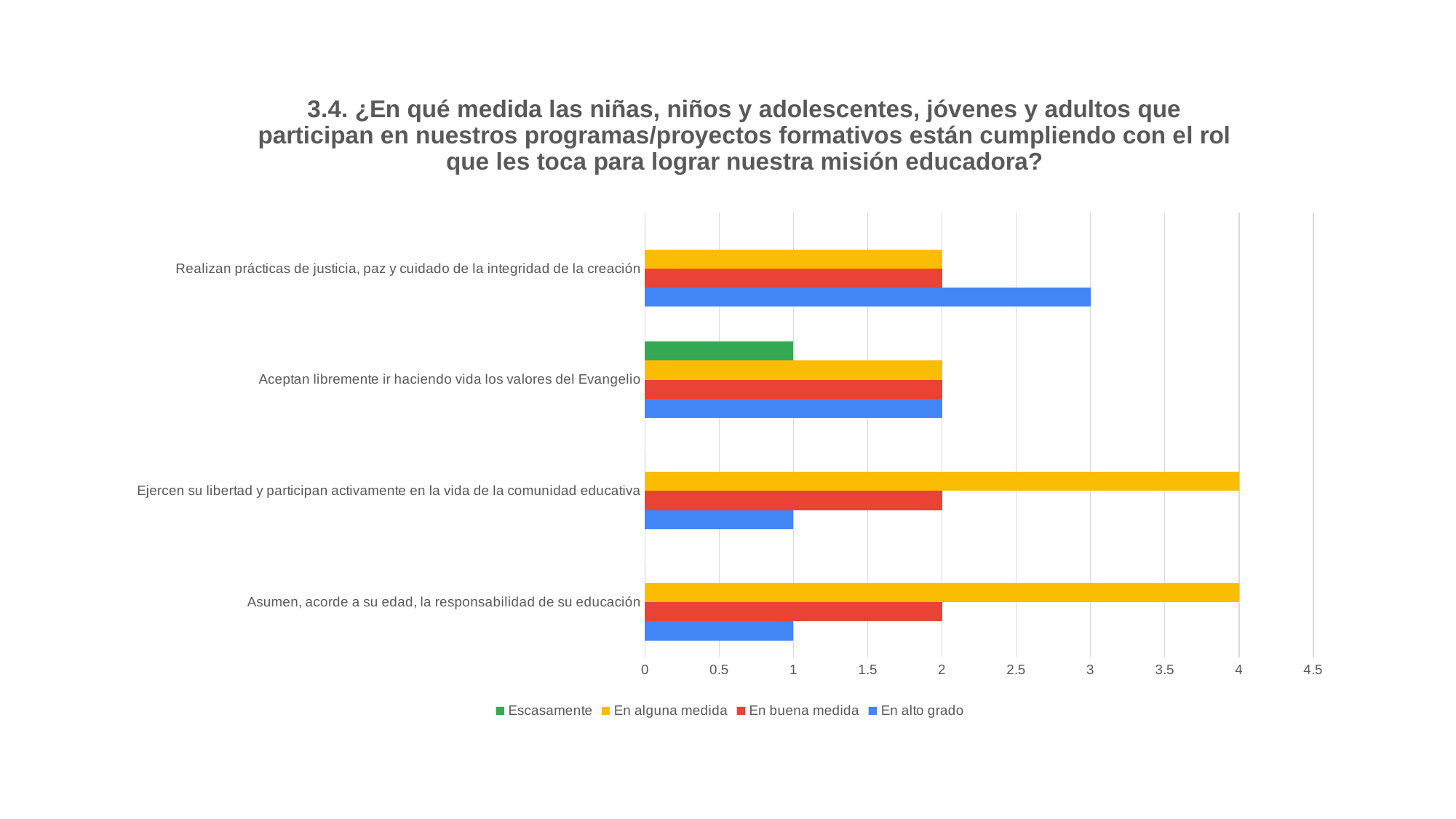
Which category has the highest value for 'En alto grado'? Realizan prácticas de justicia, paz y cuidado de la integridad de la creación What is the value of 'Escasamente' for 'Aceptan libremente ir haciendo vida los valores del Evangelio'? 1 What is the difference between 'En alguna medida' and 'En alto grado' for 'Asumen, acorde a su edad, la responsabilidad de su educación'? 3 What is the value of 'En alguna medida' for 'Ejercen su libertad y participan activamente en la vida de la comunidad educativa'? 4 How many series does the legend list? 4 What kind of chart is shown on the slide? bar chart What is the value of 'En alto grado' for 'Realizan prácticas de justicia, paz y cuidado de la integridad de la creación'? 3 Which series is shown in green in the legend? Escasamente For 'Ejercen su libertad y participan activamente en la vida de la comunidad educativa', which is larger: 'En alguna medida' or 'En buena medida'? En alguna medida What is the value of 'En alto grado' for 'Asumen, acorde a su edad, la responsabilidad de su educación'? 1 How many categories are plotted on the chart? 4